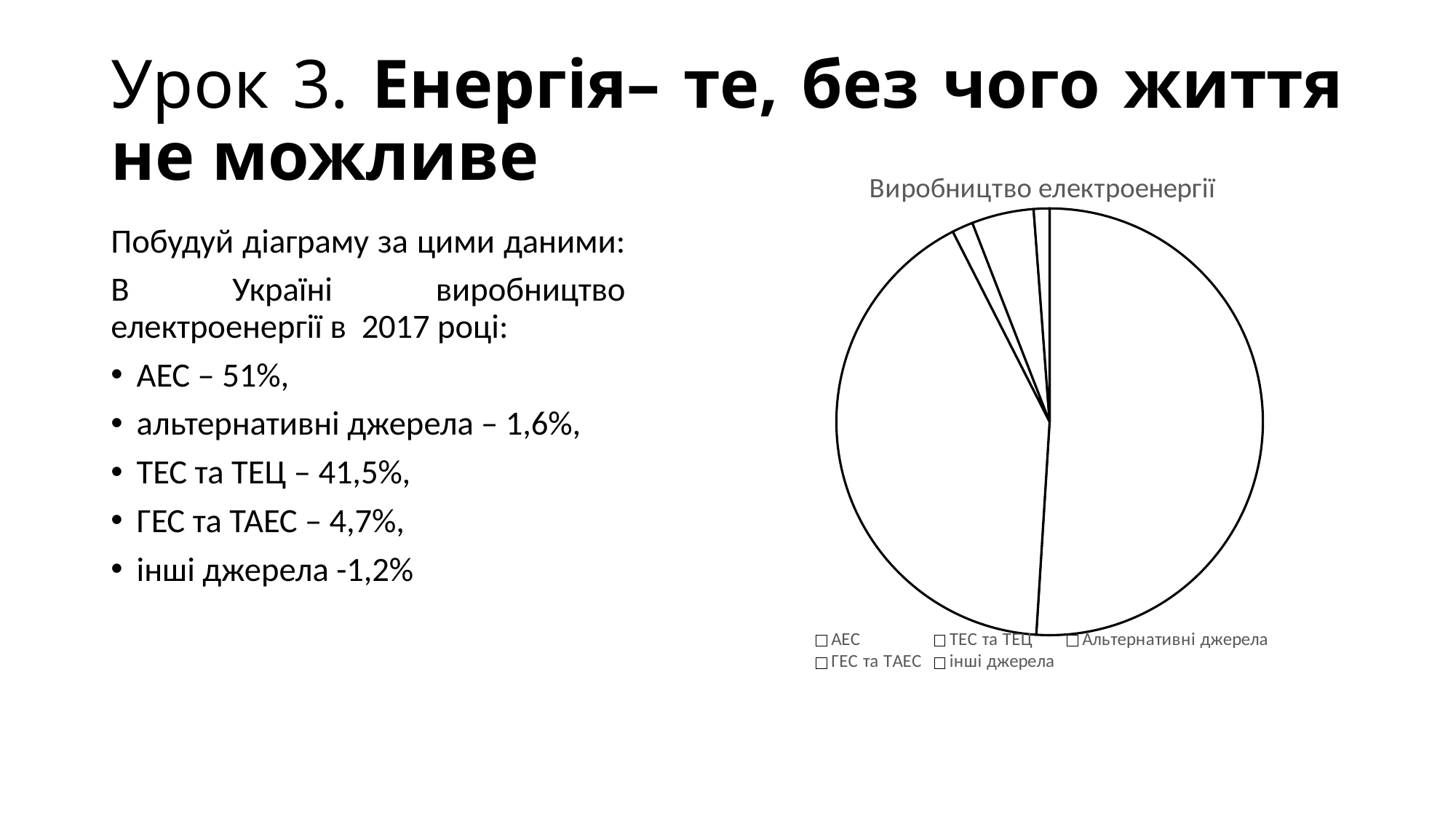
Which category has the largest share of the pie? АЕС Which is larger, the share for ГЕС та ТАЕС or the share for альтернативні джерела? ГЕС та ТАЕС What share of electricity production does АЕС account for? 51% What is the difference between the share for АЕС and the share for ТЕС та ТЕЦ? 9,5% What share of electricity production do альтернативні джерела account for? 1,6% What is the title of the chart? Виробництво електроенергії Which category has the smallest share of the pie? інші джерела What share of electricity production do ГЕС та ТАЕС account for? 4,7% What share of electricity production does ТЕС та ТЕЦ account for? 41,5% How many entries does the chart's legend list? 5 How many categories (slices) does the pie chart have? 5 What kind of chart is shown on the slide? pie chart